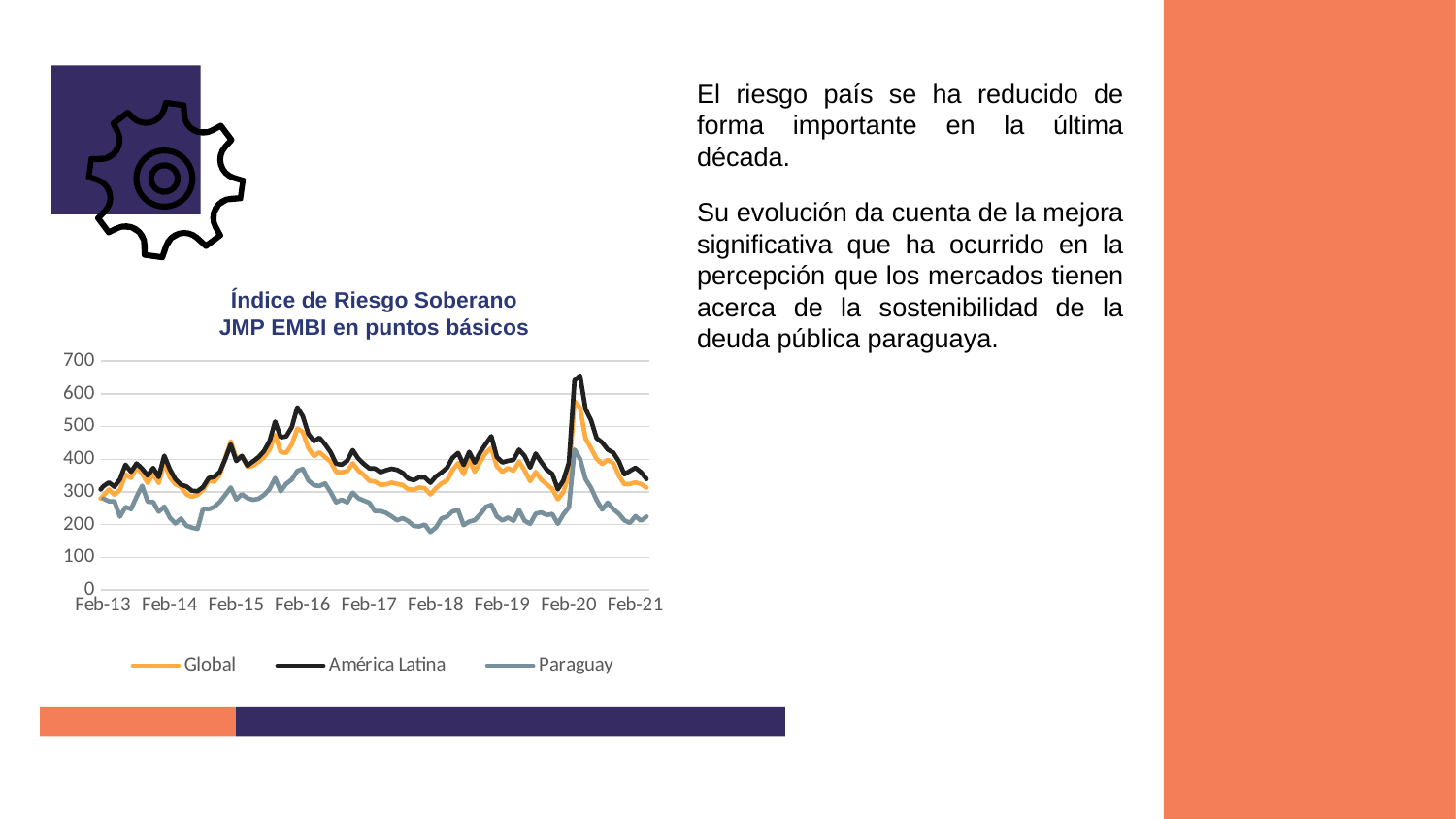
How many series does the legend of the chart list? 3 Is the lowest value for Paraguay around Feb-18 greater or less than 200? less At the spike around Feb-20, which series is higher, Paraguay or América Latina? América Latina What is the title of the chart? Índice de Riesgo Soberano JMP EMBI en puntos básicos What kind of chart is shown on the slide? Line chart Is the value for Paraguay at Feb-21 greater or less than 300? less What are the three series named in the chart legend? Global, América Latina, Paraguay Is the peak value for América Latina around Feb-20 greater or less than 600? greater How many date labels are shown on the x axis of the chart? 9 Which series reaches the highest peak in the chart? América Latina Does the Paraguay series rise or fall between Feb-16 and Feb-18? fall Which series stays lowest across most of the chart? Paraguay